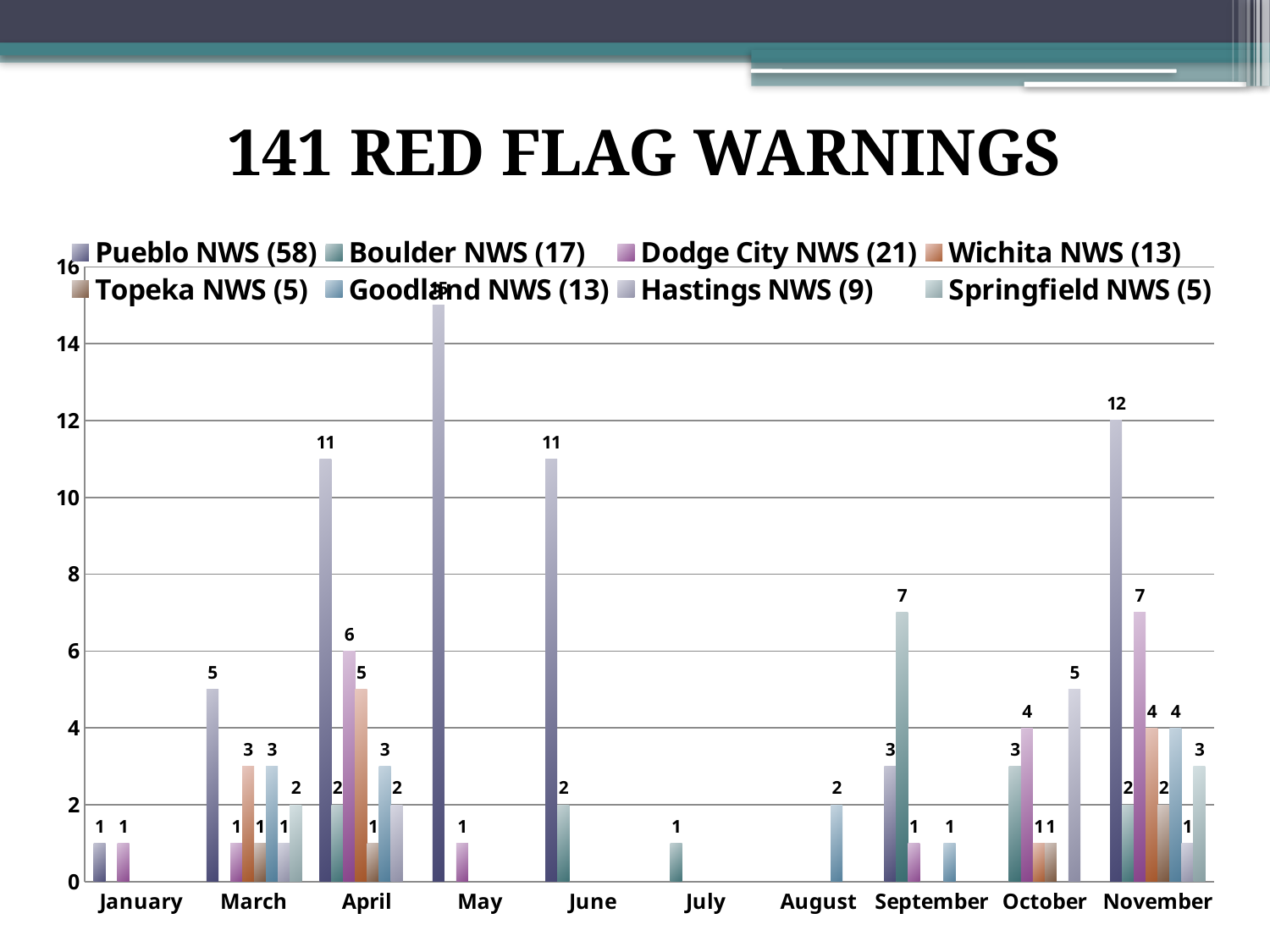
How many months are shown on the x axis? 10 What is the difference between the Dodge City NWS value and the Wichita NWS value in November? 3 What is the title of the chart? 141 RED FLAG WARNINGS What is the value for Pueblo NWS in November? 12 What kind of chart is shown on the slide? bar chart What is the value for Goodland NWS in August? 2 How many series does the legend list? 8 What is the value for Hastings NWS in October? 5 What is the value for Boulder NWS in September? 7 In which month is the Pueblo NWS value highest? May In April, which is larger: the Pueblo NWS value or the Dodge City NWS value? Pueblo NWS Is the value for Pueblo NWS in May greater or less than 14? greater